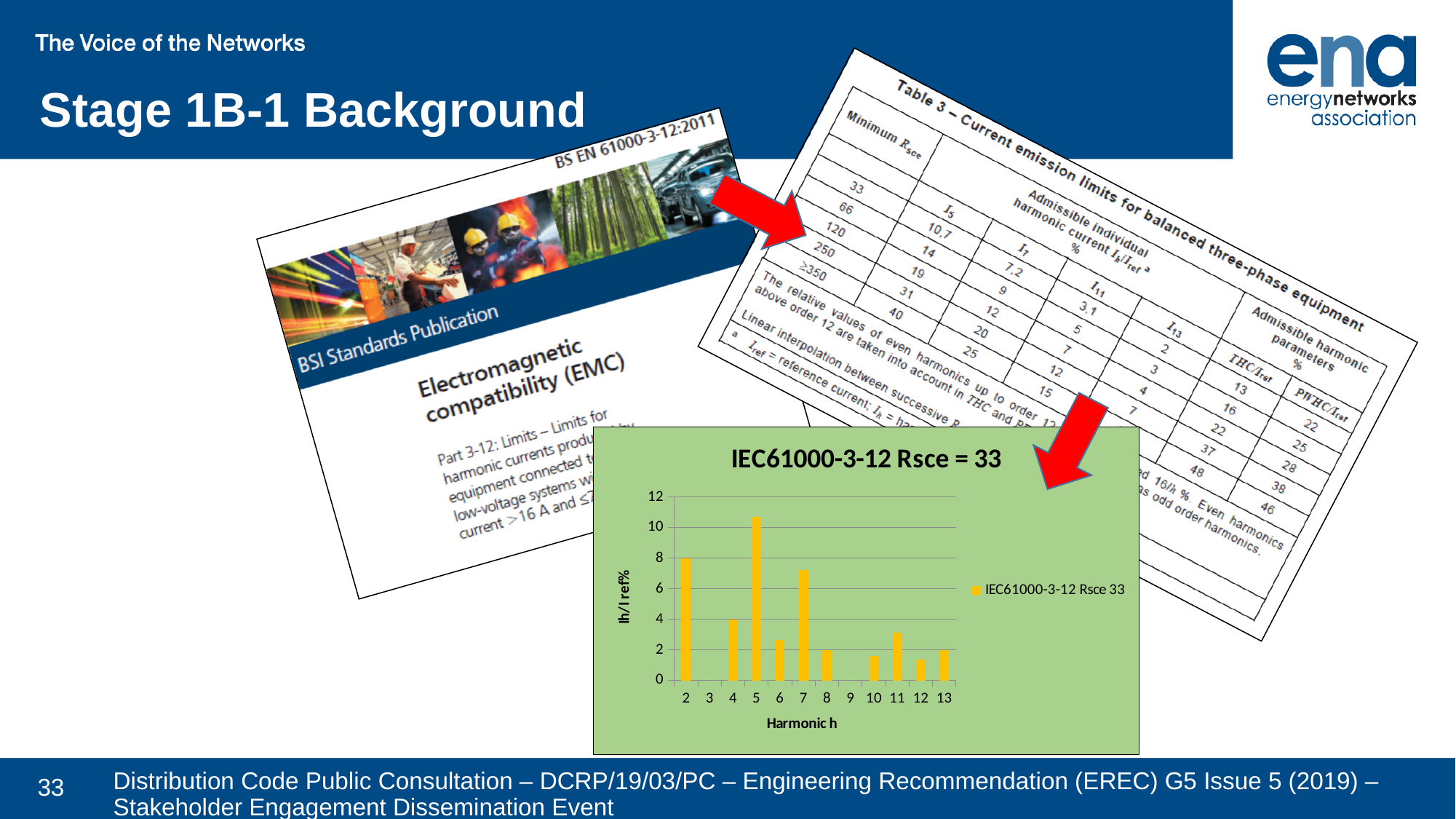
What kind of chart is shown on the slide? bar chart How many series does the chart's legend list? 1 Is the value for harmonic 7 greater or less than 6? greater Which has the larger value, harmonic 4 or harmonic 11? harmonic 4 Is the value for harmonic 10 greater or less than 2? less Which has the larger value, harmonic 2 or harmonic 7? harmonic 2 What is the label of the y axis of the chart? Ih/Iref% Which harmonic h has the highest Ih/Iref% value in the chart? 5 Is the value for harmonic 4 greater or less than 6? less How many harmonic categories are shown on the x axis of the chart? 12 What is the title of the chart? IEC61000-3-12 Rsce = 33